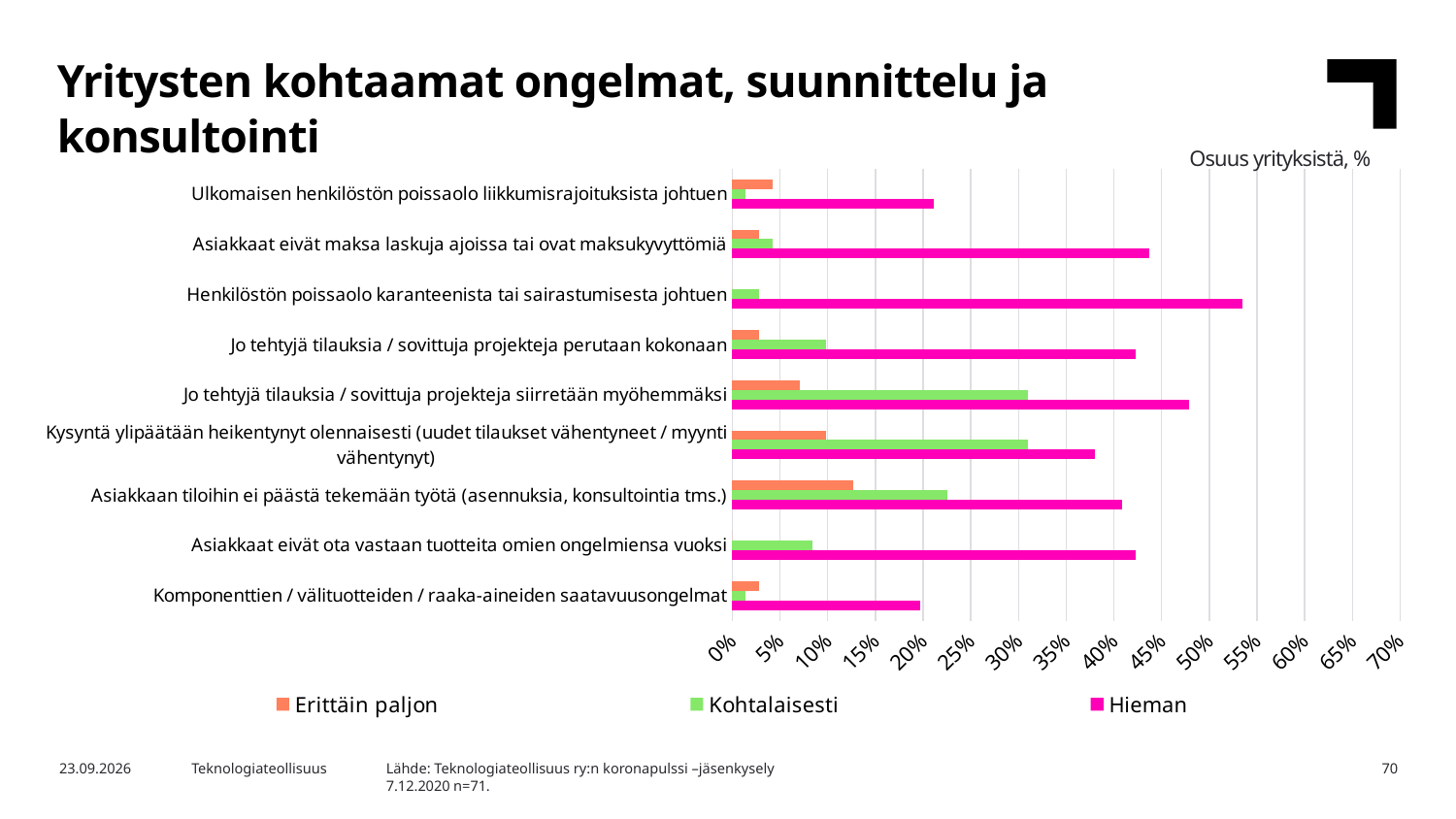
Is the 'Hieman' value for 'Komponenttien / välituotteiden / raaka-aineiden saatavuusongelmat' greater or less than 25%? less Is the 'Erittäin paljon' value for 'Kysyntä ylipäätään heikentynyt olennaisesti' greater or less than 15%? less How many categories (problem types) are plotted on the chart? 9 Which category has the highest value for the 'Erittäin paljon' series? Asiakkaan tiloihin ei päästä tekemään työtä (asennuksia, konsultointia tms.) What kind of chart is shown on the slide? Bar chart For the 'Hieman' series, which is larger: 'Asiakkaat eivät maksa laskuja ajoissa tai ovat maksukyvyttömiä' or 'Ulkomaisen henkilöstön poissaolo liikkumisrajoituksista johtuen'? Asiakkaat eivät maksa laskuja ajoissa tai ovat maksukyvyttömiä What unit label is shown above the chart's value axis? Osuus yrityksistä, % Which category has the highest value for the 'Hieman' series? Henkilöstön poissaolo karanteenista tai sairastumisesta johtuen Is the 'Kohtalaisesti' value for 'Asiakkaan tiloihin ei päästä tekemään työtä (asennuksia, konsultointia tms.)' greater or less than 20%? greater For the 'Kohtalaisesti' series, which is larger: 'Jo tehtyjä tilauksia / sovittuja projekteja siirretään myöhemmäksi' or 'Jo tehtyjä tilauksia / sovittuja projekteja perutaan kokonaan'? Jo tehtyjä tilauksia / sovittuja projekteja siirretään myöhemmäksi How many series does the legend list? 3